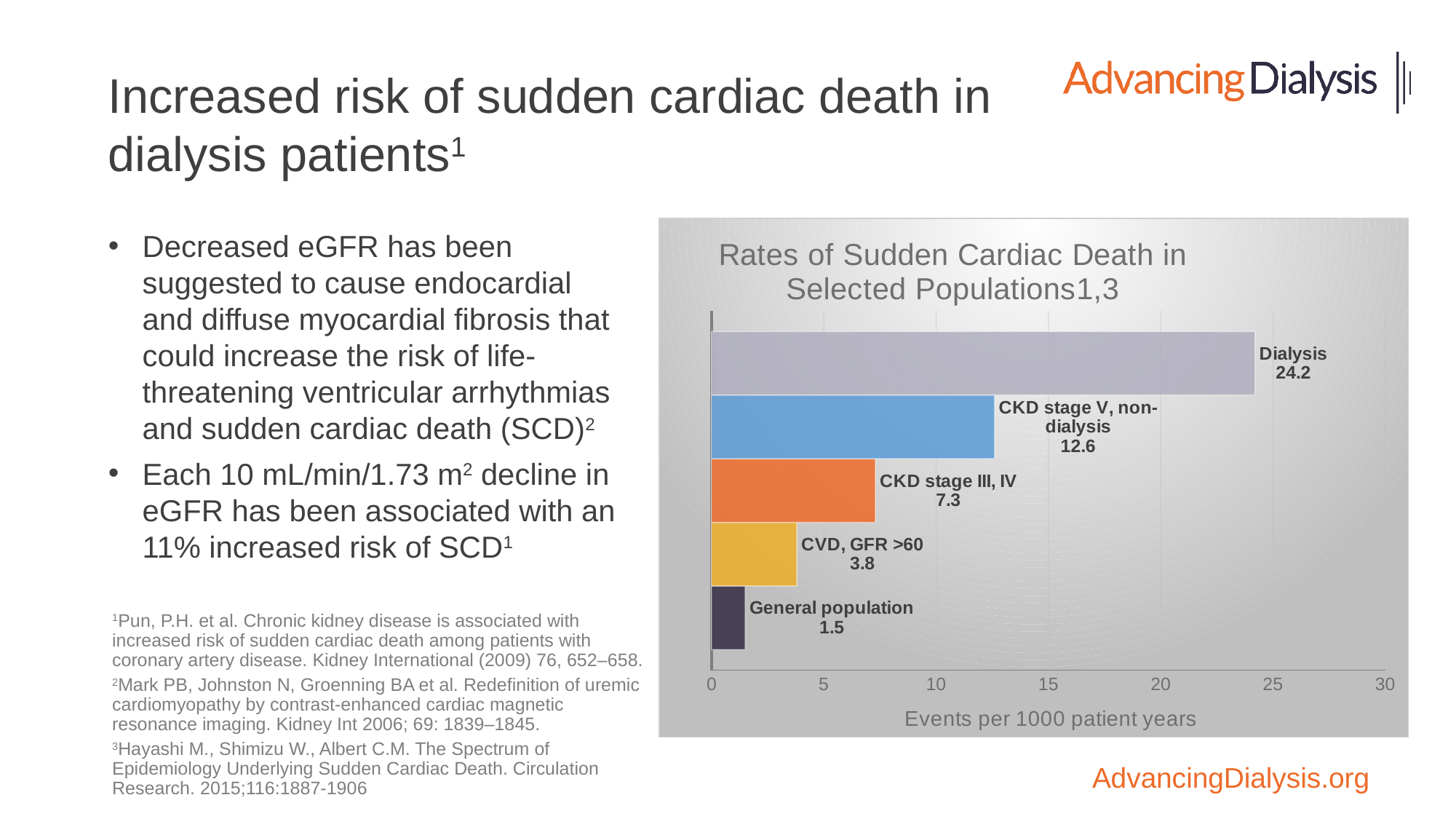
Which population has the highest rate of sudden cardiac death? Dialysis What is the difference between the Dialysis value and the CKD stage V, non-dialysis value? 11.6 What is the difference between the CKD stage III, IV value and the CVD, GFR >60 value? 3.5 What kind of chart is shown on the slide? Bar chart What is the value for CKD stage V, non-dialysis? 12.6 Which is larger, the value for CKD stage III, IV or the value for CVD, GFR >60? CKD stage III, IV How many populations are shown in the chart? 5 Which population has the lowest rate of sudden cardiac death? General population What is the value for the General population? 1.5 What is the label of the x axis of the chart? Events per 1000 patient years What is the rate of sudden cardiac death for the Dialysis population? 24.2 Is the value for Dialysis greater or less than 20? greater